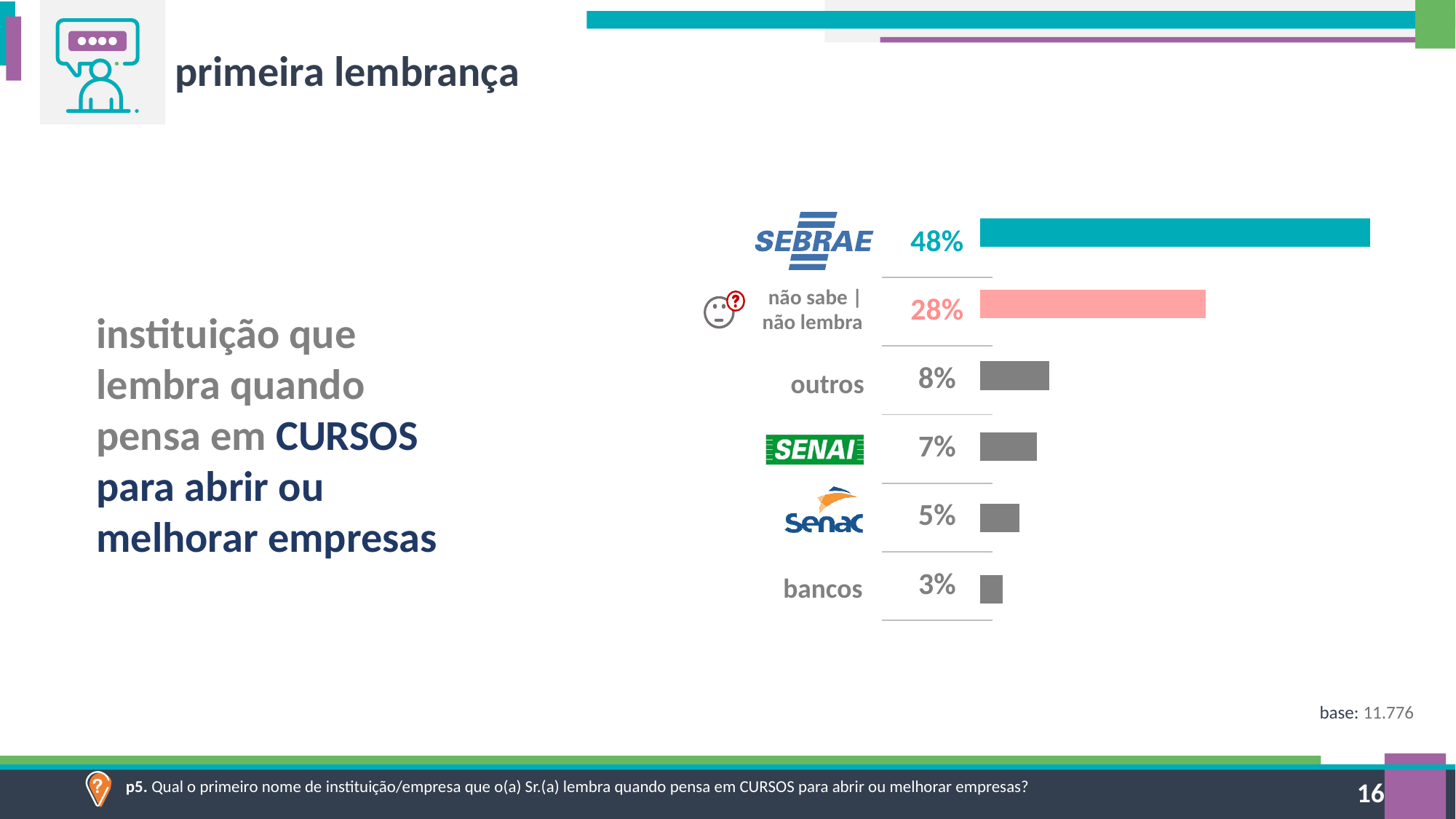
What percentage of respondents named SEBRAE as the first institution they remember when thinking of courses to open or improve businesses? 48% What is the base (number of respondents) shown on the slide? 11.776 What percentage is shown for 'bancos'? 3% Which has a larger value, SENAI or Senac? SENAI Which category has the highest value in the chart? SEBRAE What percentage is shown for 'outros'? 8% What is the value shown for 'não sabe | não lembra'? 28% How many categories are shown in the chart? 6 What is the difference between the values for SEBRAE and 'não sabe | não lembra'? 20 percentage points What kind of chart is shown on the slide? Bar chart What is the value shown for SENAI? 7% Which category has the lowest value in the chart? bancos